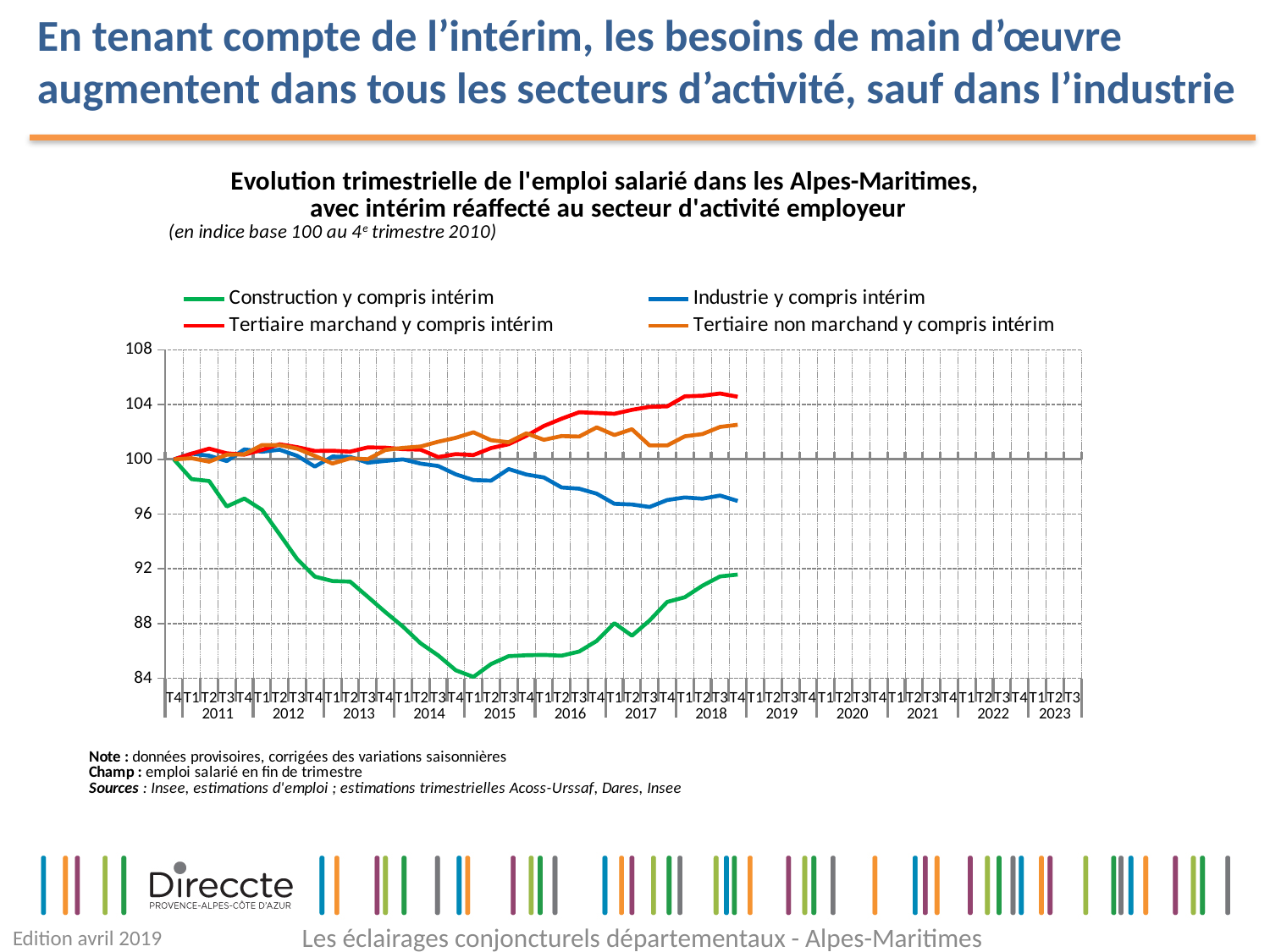
Is the value for Industrie y compris intérim at T4 2018 greater or less than 100? less Is the value for Construction y compris intérim at T1 2015 greater or less than 88? less Is the value for Construction y compris intérim at T4 2018 greater or less than 88? greater Which series is drawn in green? Construction y compris intérim Does the Construction y compris intérim series rise or fall between T4 2010 and T1 2015? fall Which series has the lowest value at the end of the plotted period (T4 2018)? Construction y compris intérim Which series reaches the highest value on the chart? Tertiaire marchand y compris intérim How many series does the legend list? 4 What kind of chart is shown on the slide? line chart At T4 2018, which series is higher: Tertiaire marchand y compris intérim or Industrie y compris intérim? Tertiaire marchand y compris intérim What is the value of all four series at T4 2010, the base period? 100